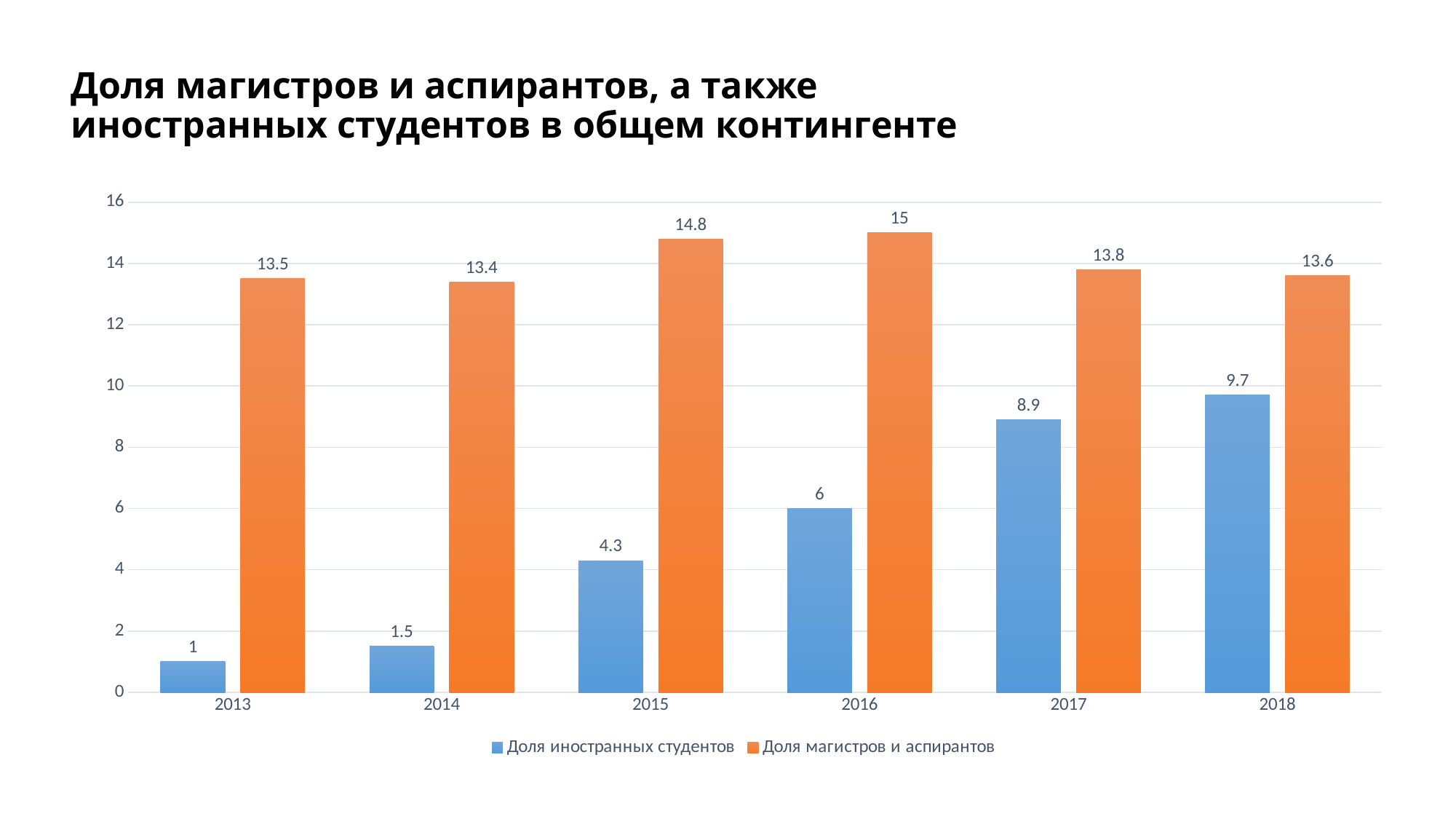
How many series does the legend list? 2 In which year is Доля магистров и аспирантов highest? 2016 What is the difference between Доля магистров и аспирантов and Доля иностранных студентов in 2017? 4.9 What is the value for Доля иностранных студентов in 2016? 6 Does Доля иностранных студентов rise or fall from 2013 to 2018? Rise Is the value for Доля иностранных студентов in 2017 greater or less than 8? greater Which is larger in 2014: Доля иностранных студентов or Доля магистров и аспирантов? Доля магистров и аспирантов How many years are shown on the x axis? 6 What is the value for Доля магистров и аспирантов in 2015? 14.8 What is the value for Доля иностранных студентов in 2018? 9.7 In which year is Доля иностранных студентов lowest? 2013 What kind of chart is shown on the slide? Bar chart